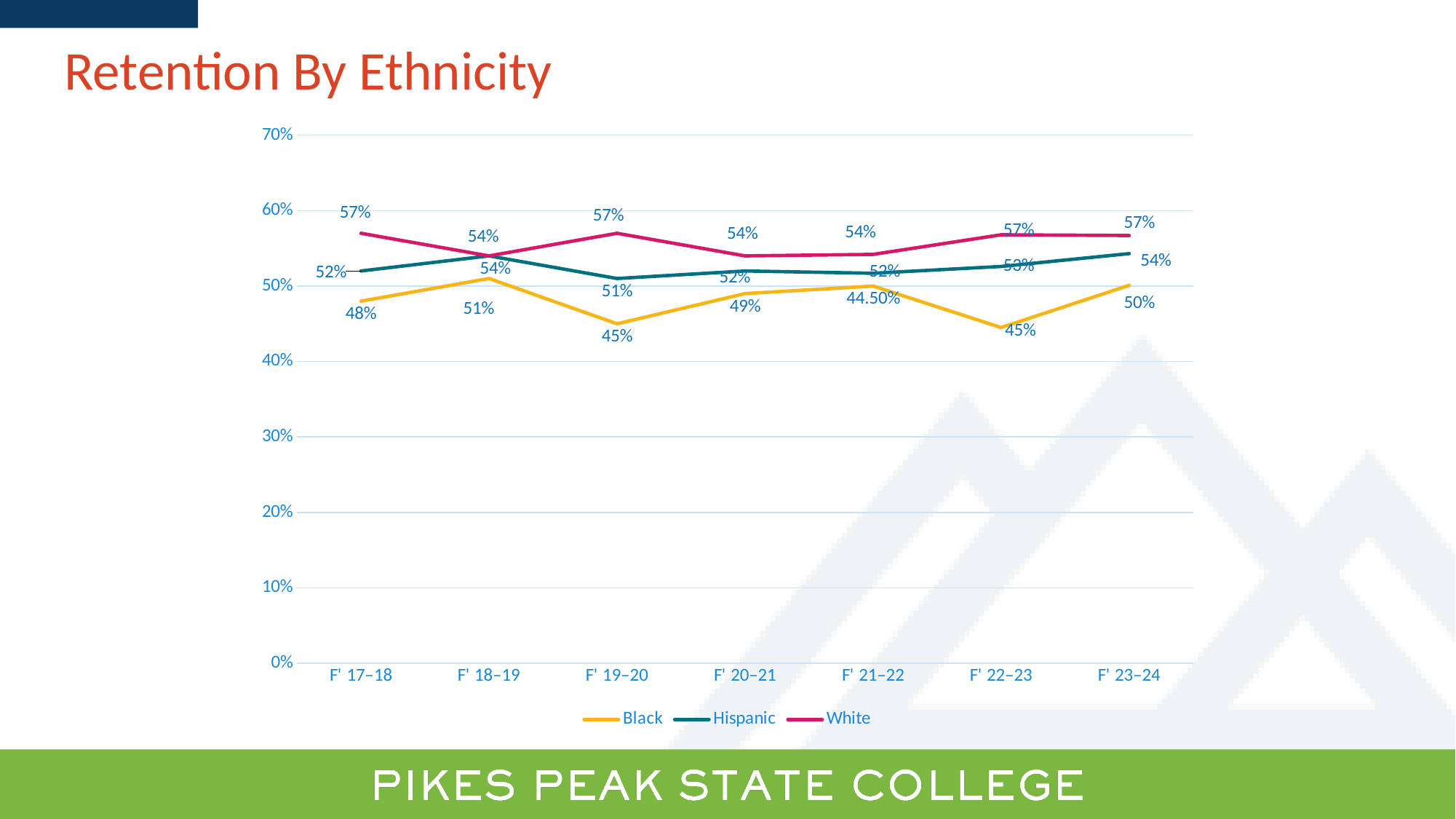
What is the retention rate for Black students in F' 19–20? 45% Is the Black retention rate in F' 19–20 greater or less than 50%? less How many fall terms are plotted along the x axis? 7 What is the retention rate for Hispanic students in F' 23–24? 54% In F' 17–18, which group has the higher retention rate, White or Hispanic? White How many series does the legend list? 3 What is the retention rate for Black students in F' 23–24? 50% What kind of chart is shown on the slide? Line chart What is the difference between the White and Black retention rates in F' 19–20? 12 percentage points In which term is the Hispanic retention rate lowest? F' 19–20 In which term is the Black retention rate highest? F' 18–19 What is the retention rate for White students in F' 17–18? 57%